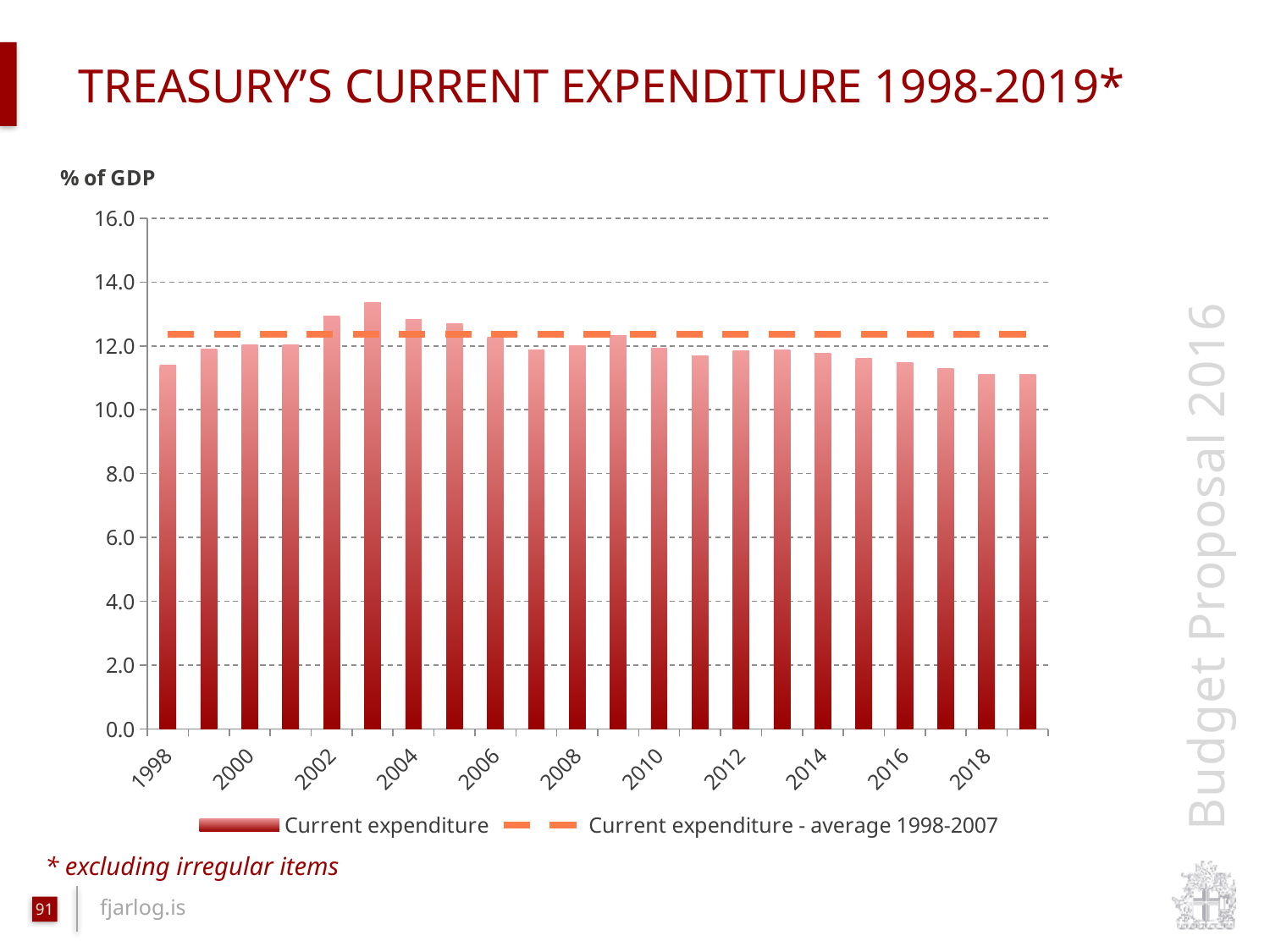
What unit is shown on the y-axis label of the chart? % of GDP Is the value for 2003 greater or less than 14.0? less Which is larger, the current expenditure for 2002 or for 2010? 2002 How many series does the legend list? 2 Is the value for 2003 greater or less than 12.0? greater Do the current expenditure values rise or fall from 2009 to 2019? fall Which year has the highest current expenditure as a % of GDP? 2003 What kind of chart is shown on the slide? bar chart Is the value for 2019 greater or less than 12.0? less Which is larger, the current expenditure for 2003 or for 2019? 2003 How many years (bars) are plotted in the chart? 22